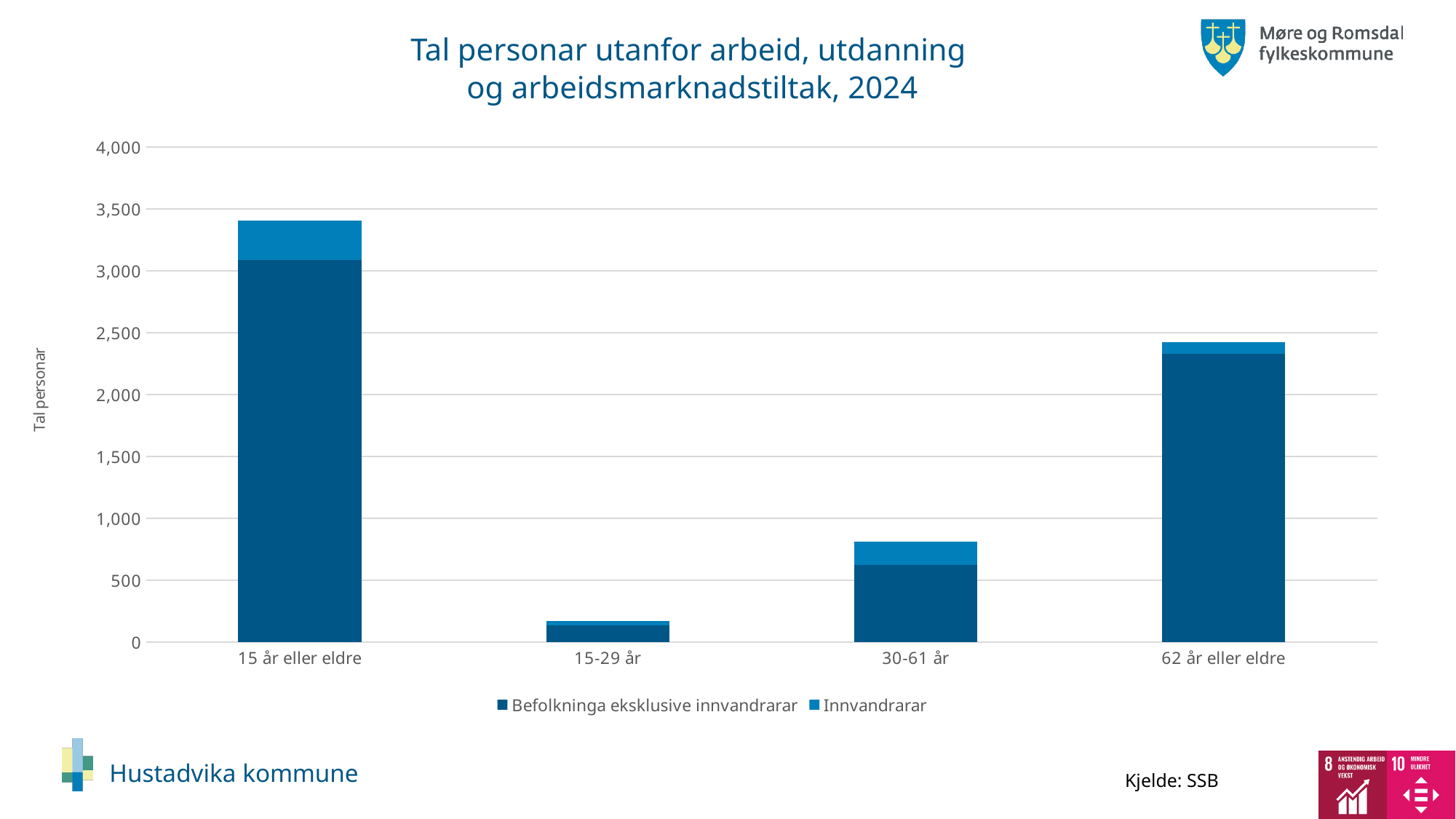
Is the total value for 30-61 år greater or less than 1,000? less How many series does the legend list? 2 Which has a larger total bar, 30-61 år or 62 år eller eldre? 62 år eller eldre Is the total value for 62 år eller eldre greater or less than 2,000? greater Which age category has the shortest total bar? 15-29 år Which age category has the tallest total bar? 15 år eller eldre How many age categories are shown on the x axis? 4 What is the label of the y axis? Tal personar What is the source cited on the slide? SSB Is the total value for 15-29 år greater or less than 500? less What kind of chart is shown on the slide? Stacked bar chart